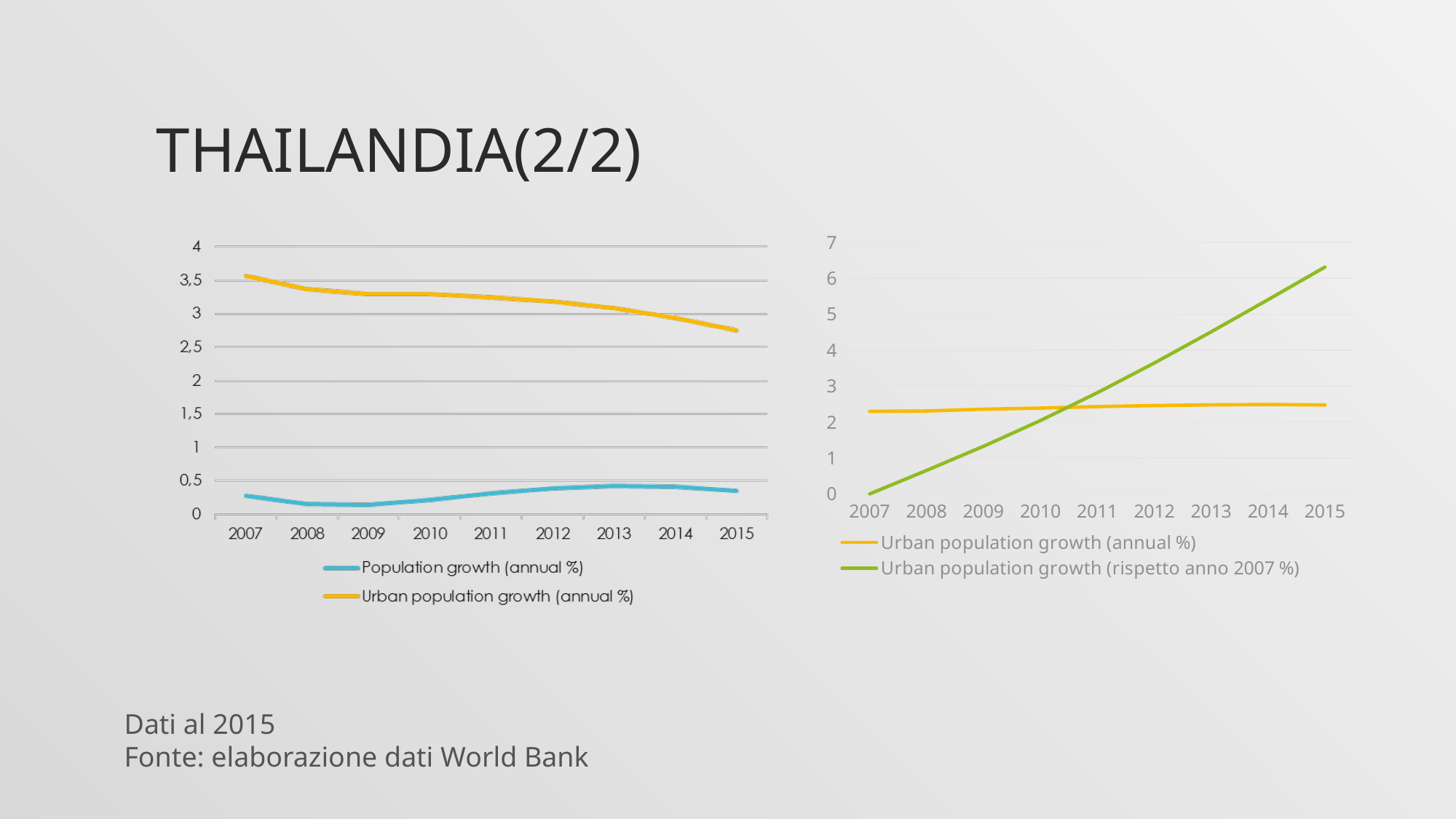
In the right chart, what colour is the line for Urban population growth (rispetto anno 2007 %)? green What kind of chart is the chart on the right of the slide? line chart In the right chart, does the Urban population growth (rispetto anno 2007 %) line rise or fall from 2007 to 2015? rise In the left chart, is the value for Population growth (annual %) in 2013 greater or less than 0.5? less In the right chart, which series has the larger value in 2015: Urban population growth (annual %) or Urban population growth (rispetto anno 2007 %)? Urban population growth (rispetto anno 2007 %) In the left chart, does the Urban population growth (annual %) line rise or fall from 2007 to 2015? fall How many series does the legend of the left chart list? 2 In the left chart, is the value for Urban population growth (annual %) in 2015 greater or less than 3? less How many years are shown on the x axis of the right chart? 9 In the right chart, is the value for Urban population growth (rispetto anno 2007 %) in 2015 greater or less than 6? greater In the left chart, which series has the larger value in 2007: Population growth (annual %) or Urban population growth (annual %)? Urban population growth (annual %) What kind of chart is the chart on the left of the slide? line chart